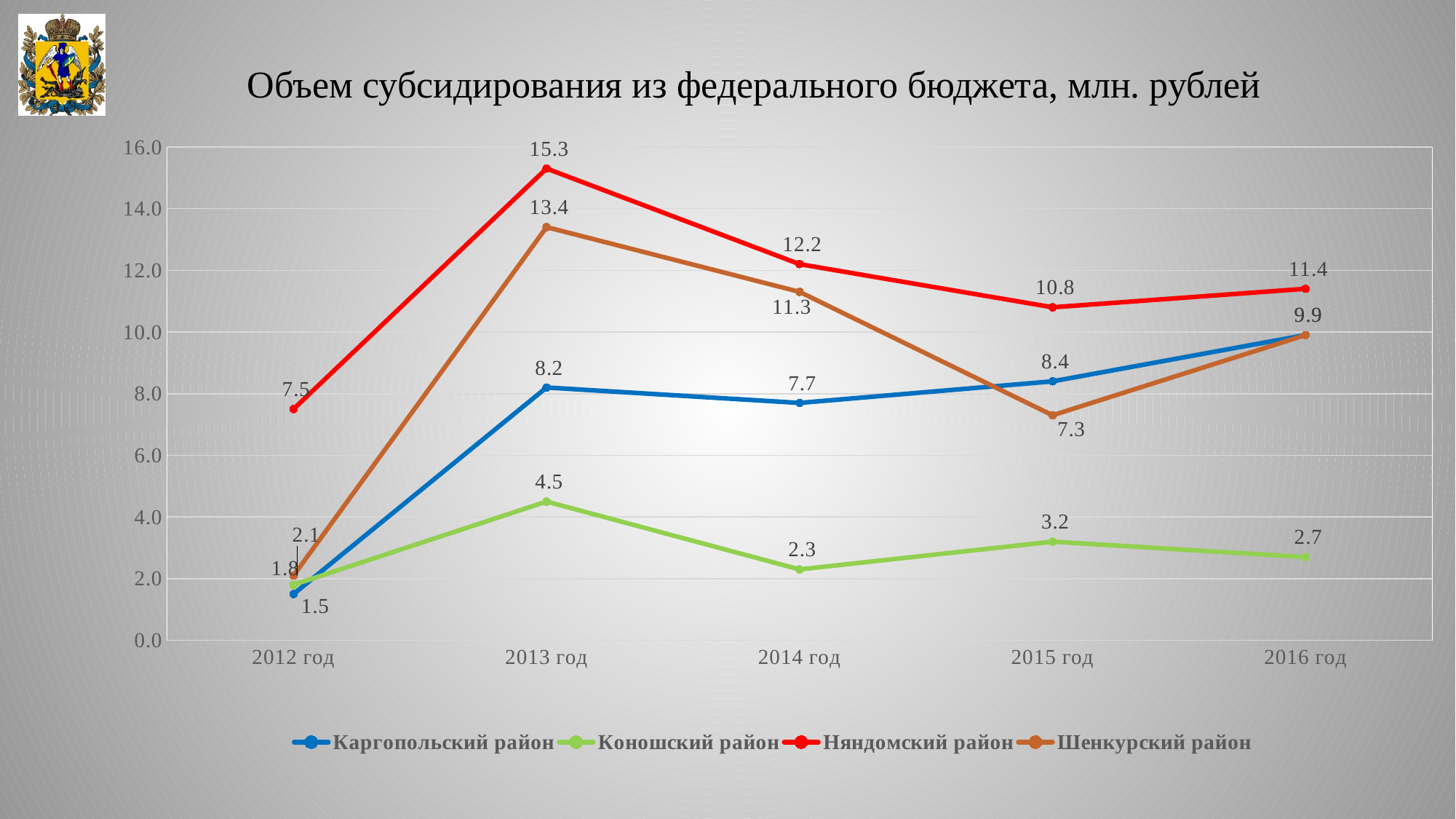
Which is larger in 2014 год: Каргопольский район or Коношский район? Каргопольский район What is the title of the chart? Объем субсидирования из федерального бюджета, млн. рублей What kind of chart is shown on the slide? line chart Which district has the lowest value in 2015 год? Коношский район In which year does Няндомский район reach its highest value? 2013 год What is the value for Няндомский район in 2013 год? 15.3 What is the difference between Няндомский район and Шенкурский район in 2013 год? 1.9 What is the value for Каргопольский район in 2015 год? 8.4 How many series does the legend list? 4 What is the value for Шенкурский район in 2015 год? 7.3 Does the value for Коношский район rise or fall from 2013 год to 2014 год? fall How many years are shown on the x axis? 5